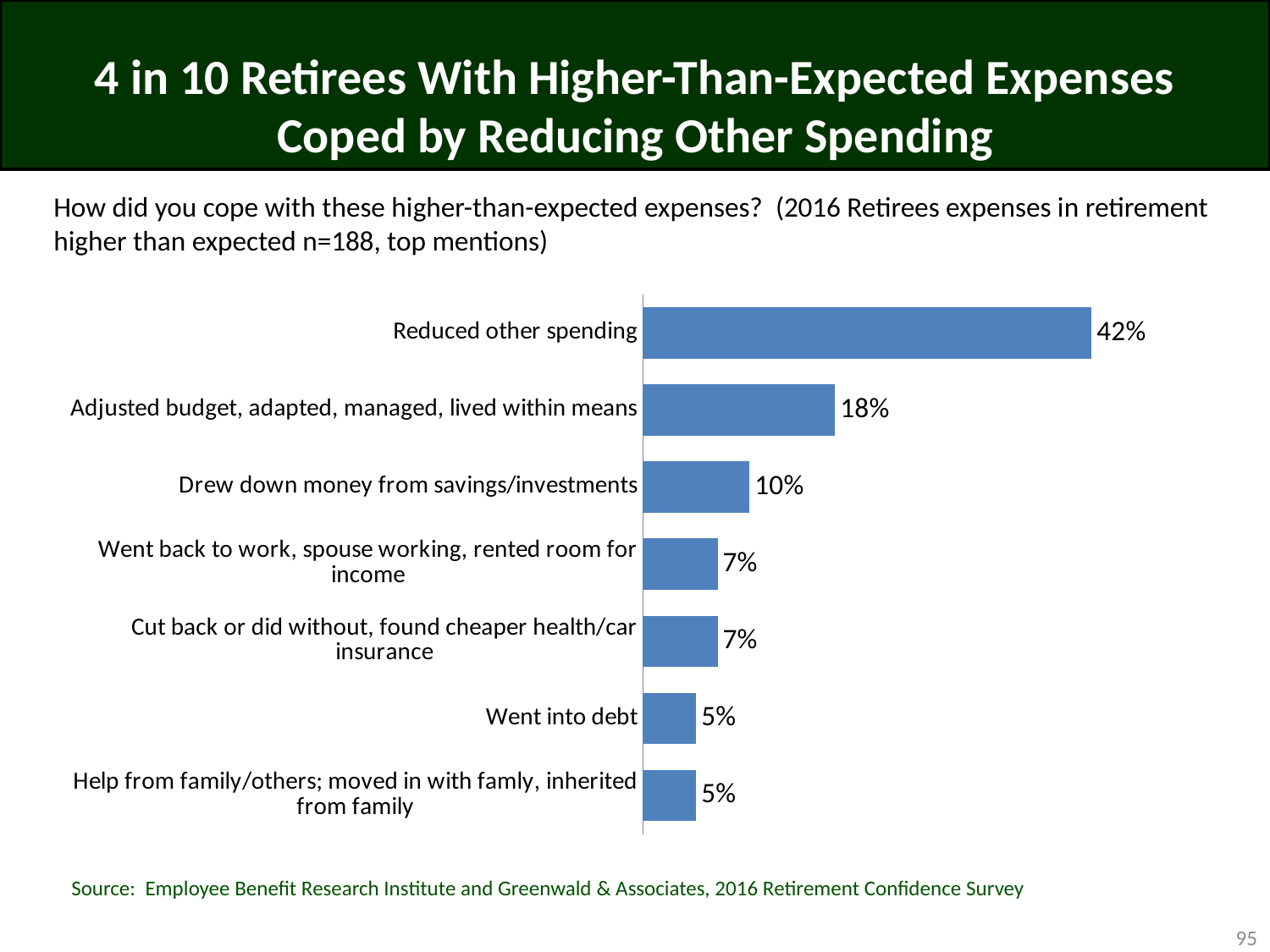
Which coping method has the highest percentage? Reduced other spending What is the value for 'Drew down money from savings/investments'? 10% What is the value for 'Adjusted budget, adapted, managed, lived within means'? 18% What percentage of retirees went into debt? 5% What is the difference between 'Reduced other spending' and 'Adjusted budget, adapted, managed, lived within means'? 24% What is the difference between 'Drew down money from savings/investments' and 'Went into debt'? 5% What is the sample size (n) stated in the chart's question text? 188 What is the value for 'Went back to work, spouse working, rented room for income'? 7% What kind of chart is shown on the slide? Bar chart How many coping methods are shown in the chart? 7 What percentage of retirees reduced other spending to cope with higher-than-expected expenses? 42% Which is larger: 'Adjusted budget, adapted, managed, lived within means' or 'Drew down money from savings/investments'? Adjusted budget, adapted, managed, lived within means